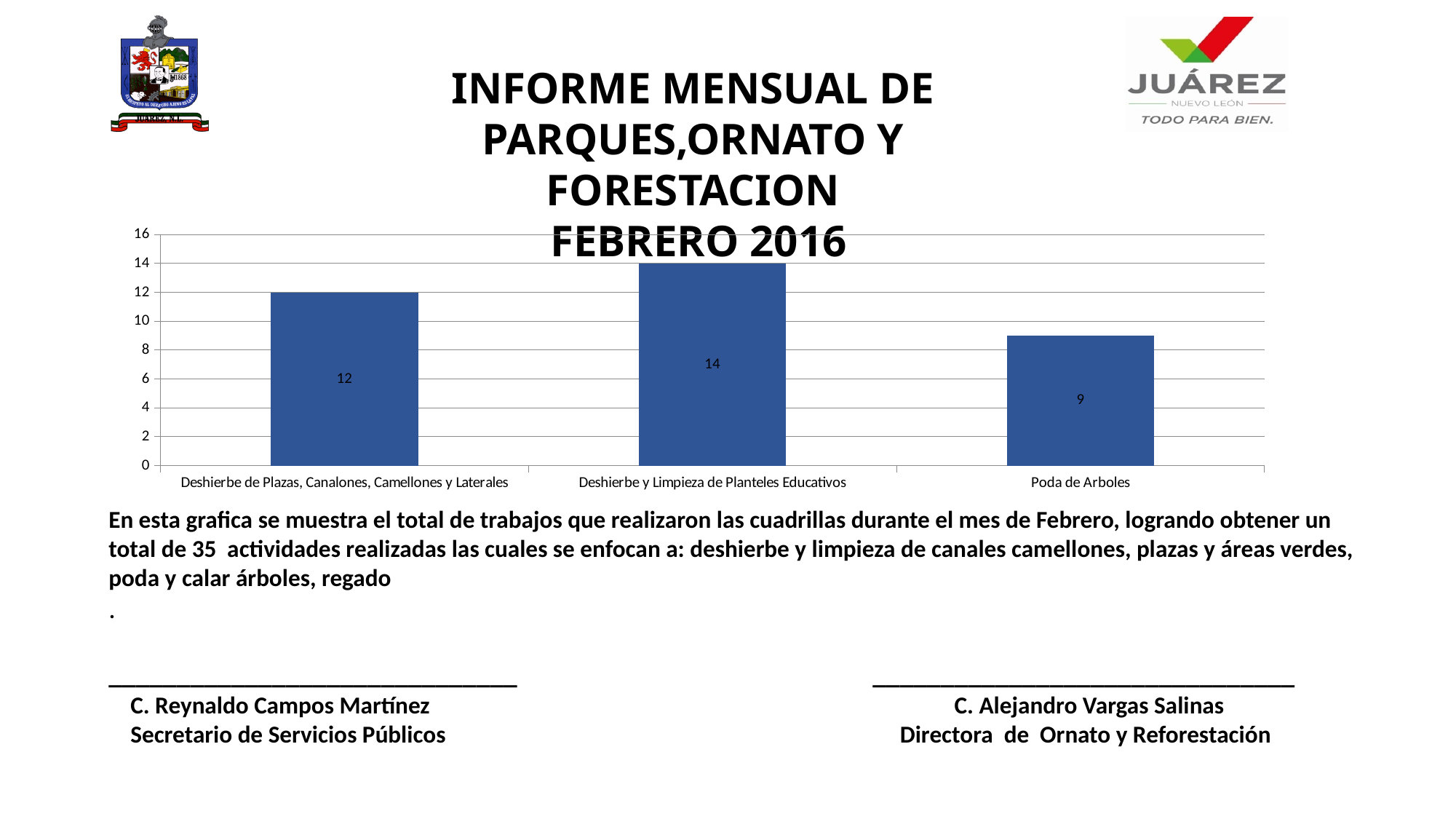
What is the value for Poda de Arboles? 9 What is the value for Deshierbe y Limpieza de Planteles Educativos? 14 What kind of chart is shown on the slide? bar chart Which category has the lowest value? Poda de Arboles Which category has the highest value? Deshierbe y Limpieza de Planteles Educativos What is the highest value shown on the vertical axis? 16 How many categories are shown in the chart? 3 What is the value for Deshierbe de Plazas, Canalones, Camellones y Laterales? 12 Which is larger: the value for Deshierbe de Plazas, Canalones, Camellones y Laterales or the value for Deshierbe y Limpieza de Planteles Educativos? Deshierbe y Limpieza de Planteles Educativos Is the value for Poda de Arboles greater or less than 10? less What is the difference between the values for Deshierbe de Plazas, Canalones, Camellones y Laterales and Poda de Arboles? 3 What is the difference between the values for Deshierbe y Limpieza de Planteles Educativos and Poda de Arboles? 5